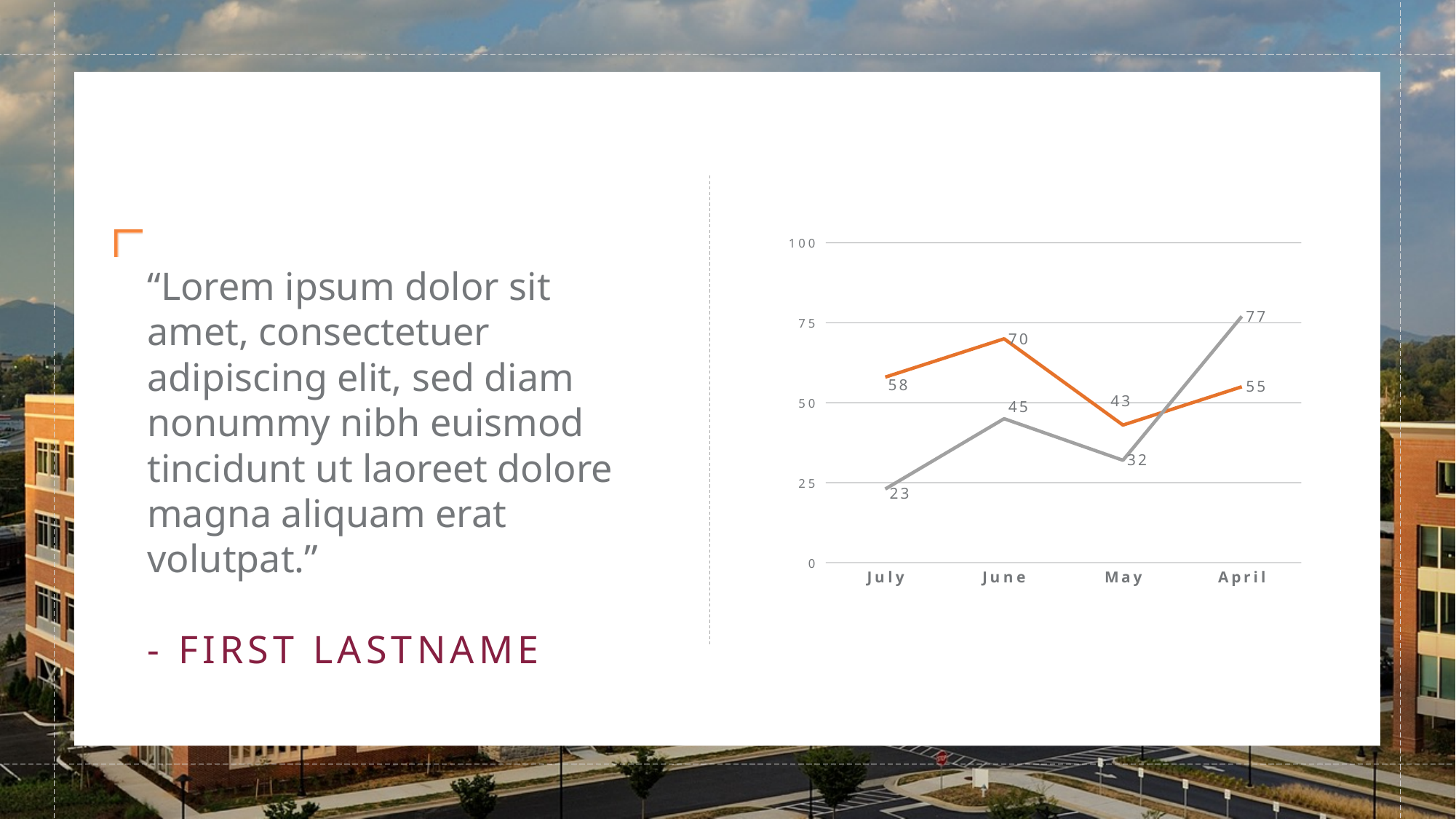
What is the difference between the gray line's value for April and the orange line's value for April? 22 Is the gray line's value for May greater or less than 50? less What is the value of the gray line for July? 23 What is the value of the gray line for April? 77 How many categories are shown on the x axis of the chart? 4 For which month does the gray line have its lowest value? July What is the difference between the orange line's value for June and its value for May? 27 What type of chart is shown on the slide? line chart What is the value of the orange line for June? 70 Which line has the larger value for April, the orange line or the gray line? the gray line For which month does the orange line reach its highest value? June What is the value of the orange line for May? 43